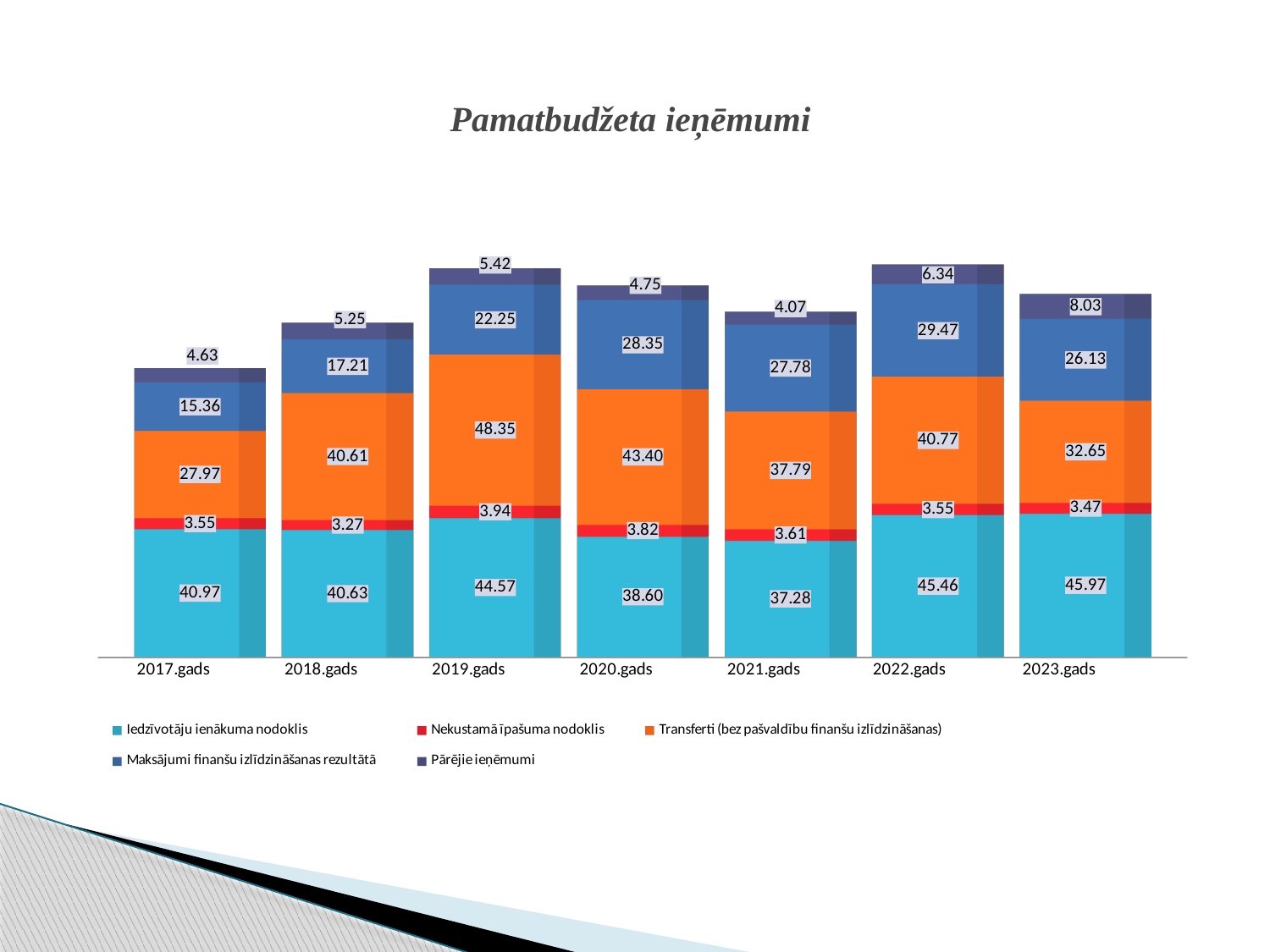
How many series does the legend list? 5 What is the value of Transferti (bez pašvaldību finanšu izlīdzināšanas) for 2023.gads? 32.65 What is the value of Maksājumi finanšu izlīdzināšanas rezultātā for 2020.gads? 28.35 In which year is the Maksājumi finanšu izlīdzināšanas rezultātā value lowest? 2017.gads What is the value of Iedzīvotāju ienākuma nodoklis for 2019.gads? 44.57 What is the difference between the Iedzīvotāju ienākuma nodoklis values for 2023.gads and 2017.gads? 5.00 What is the value of Pārējie ieņēmumi for 2021.gads? 4.07 How many years are shown on the x axis? 7 What is the total of the stacked bar for 2017.gads? 92.48 In which year is the Transferti (bez pašvaldību finanšu izlīdzināšanas) value highest? 2019.gads What kind of chart is shown on the slide? Stacked bar chart Which is larger: Nekustamā īpašuma nodoklis for 2019.gads or for 2018.gads? 2019.gads